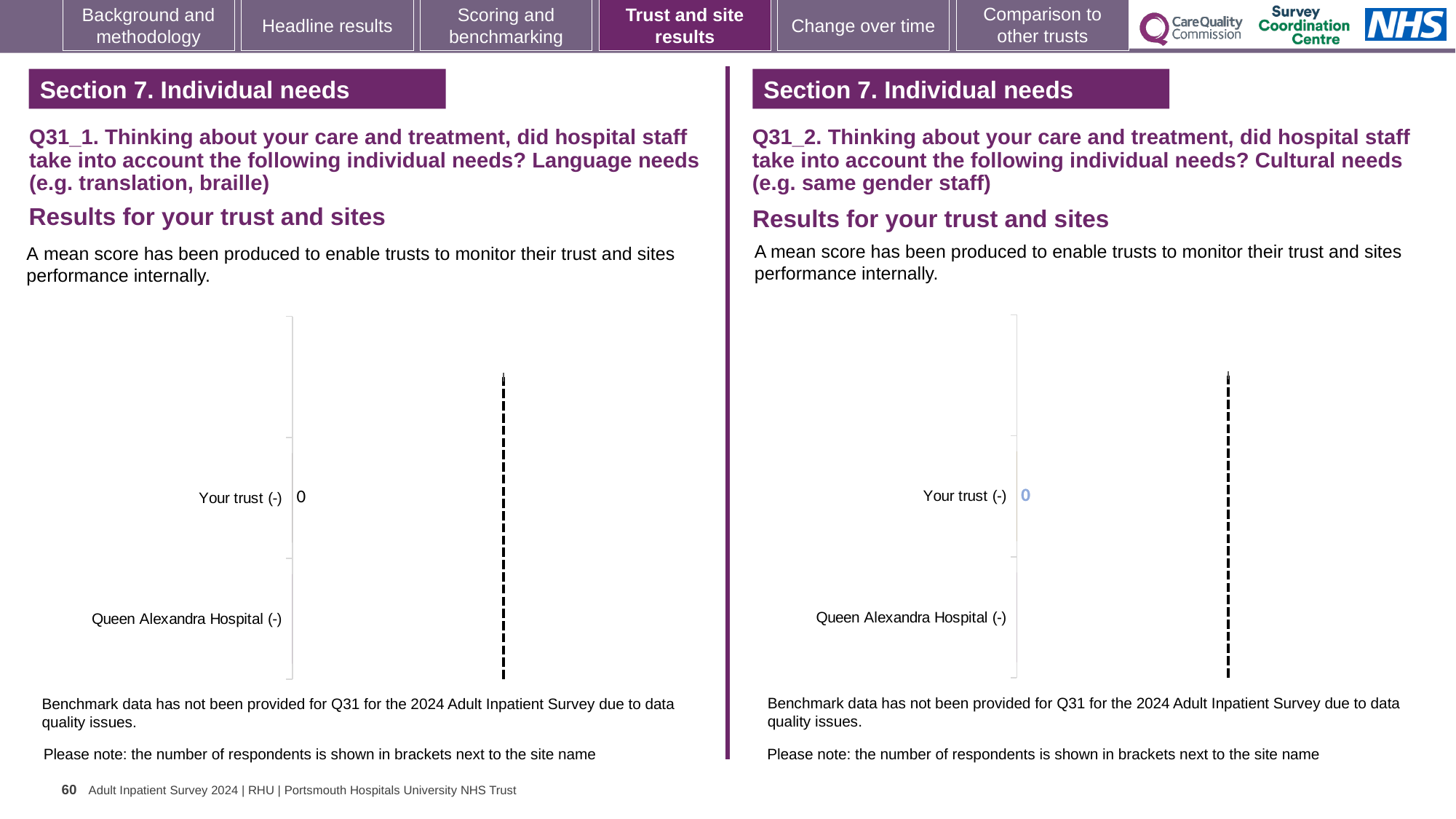
On the left chart (Q31_1, Language needs), what is the value shown for Your trust? 0 On the right chart (Q31_2, Cultural needs), what is the value shown for Your trust? 0 On the right chart (Q31_2, Cultural needs), how many categories are listed on the vertical axis? 2 On the left chart (Q31_1, Language needs), what is the label of the category listed below Your trust? Queen Alexandra Hospital (-) On the left chart (Q31_1, Language needs), how many categories are listed on the vertical axis? 2 On the right chart (Q31_2, Cultural needs), what is shown in brackets next to the site name Queen Alexandra Hospital? -